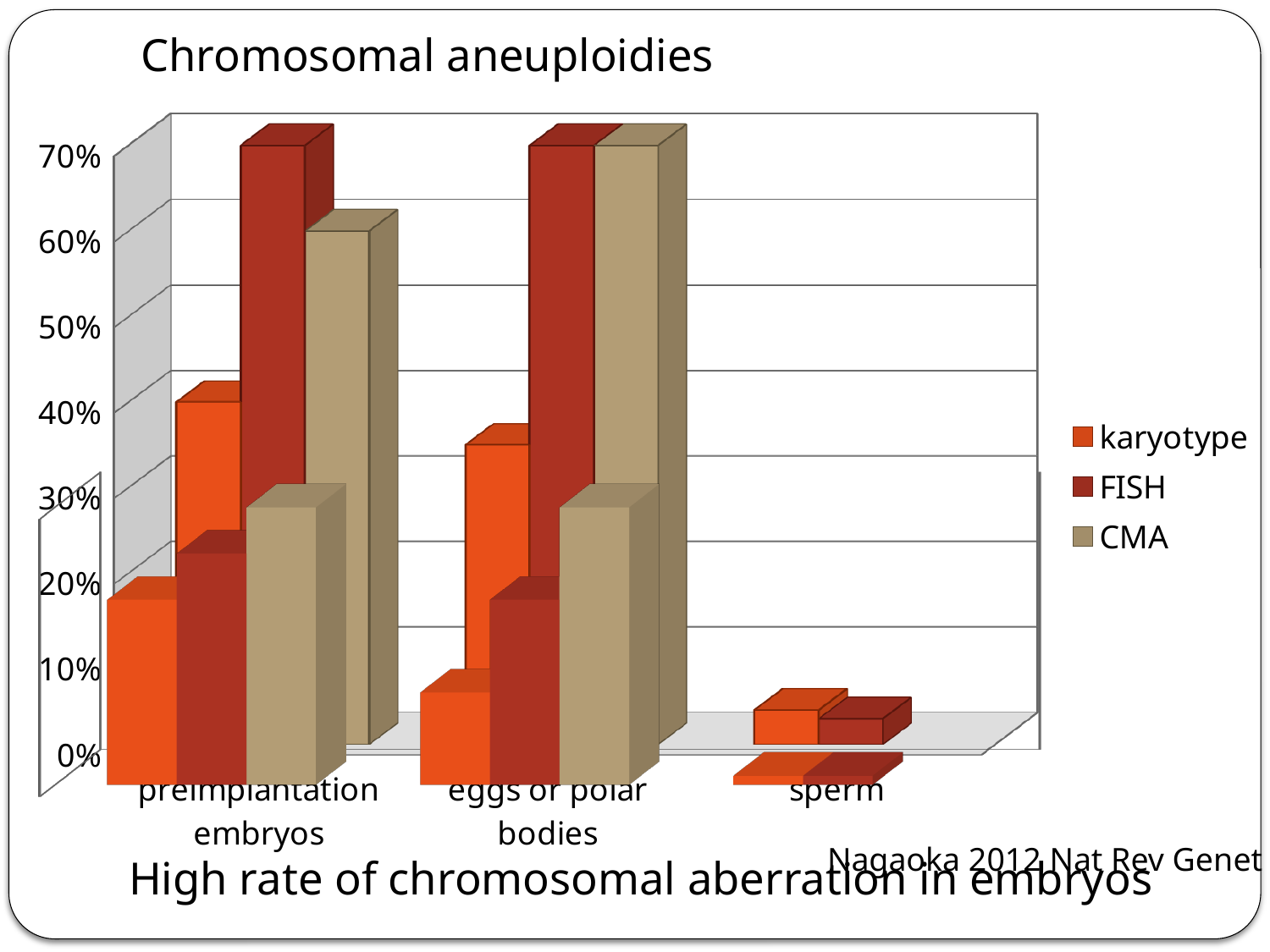
How many series does the legend list? 3 Is the FISH value for sperm greater or less than 10%? less Is the karyotype value for sperm greater or less than 10%? less How many categories are shown on the x axis? 3 Which category has the lowest values across all series? sperm What is the title of the chart? Chromosomal aneuploidies What kind of chart is shown on the slide? bar chart Which series are listed in the legend? karyotype, FISH, CMA Which is larger, the FISH value for sperm or the FISH value for eggs or polar bodies? eggs or polar bodies Which is larger, the karyotype value for sperm or the karyotype value for preimplantation embryos? preimplantation embryos